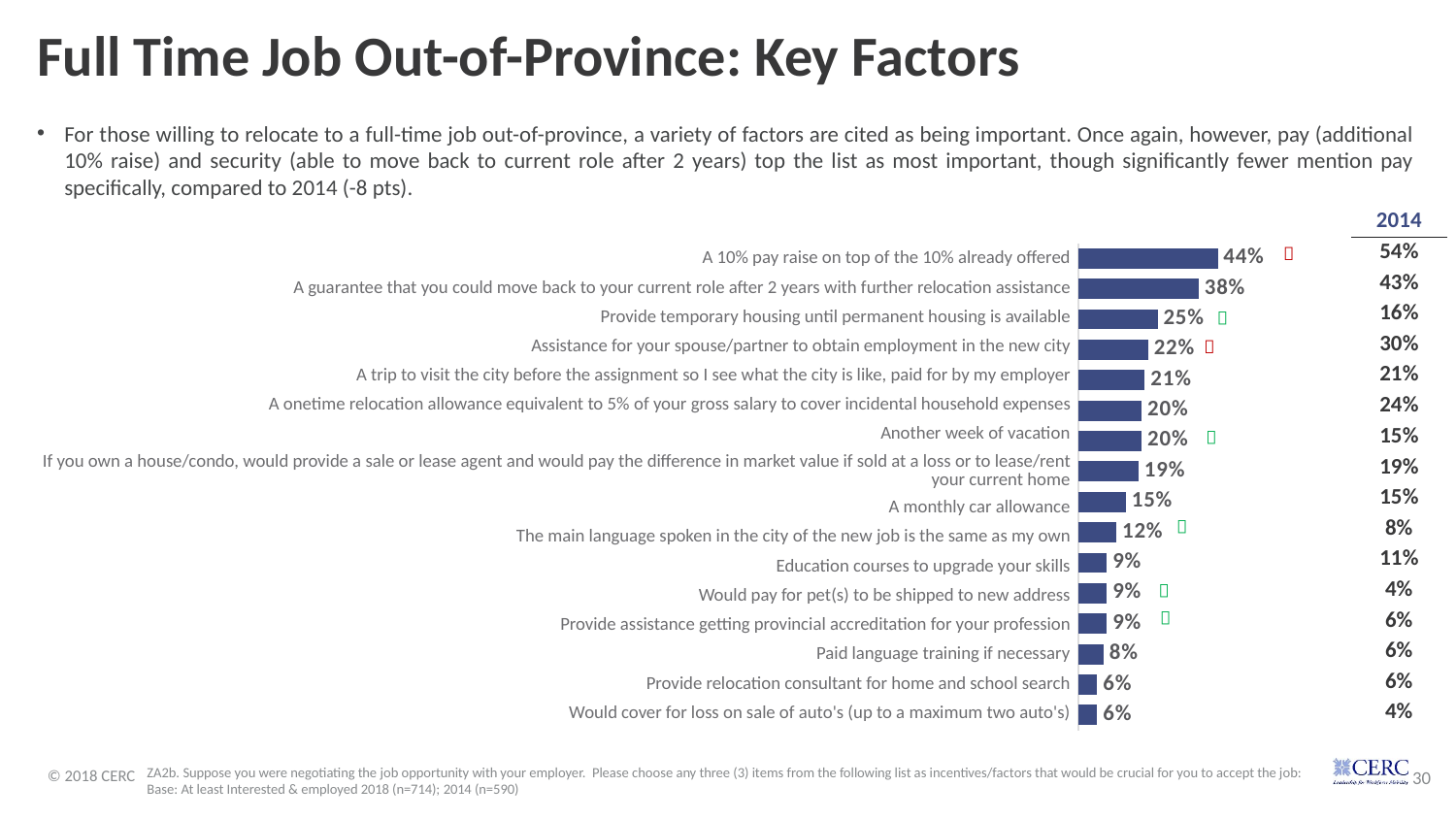
What is the value for "A monthly car allowance"? 15% What is the lowest value shown in the chart? 6% What is the difference between the value for "A 10% pay raise on top of the 10% already offered" and "A guarantee that you could move back to your current role after 2 years with further relocation assistance"? 6 percentage points Which is larger: the value for "Provide temporary housing until permanent housing is available" or "Assistance for your spouse/partner to obtain employment in the new city"? Provide temporary housing until permanent housing is available What year is shown as the column header to the right of the chart? 2014 What is the value for "Another week of vacation"? 20% How many factors (categories) are plotted in the chart? 16 Which factor has the highest value in the chart? A 10% pay raise on top of the 10% already offered What is the 2014 value listed for "A 10% pay raise on top of the 10% already offered"? 54% What is the value for "A 10% pay raise on top of the 10% already offered"? 44% What is the value for "Paid language training if necessary"? 8% What type of chart is shown on the slide? Bar chart